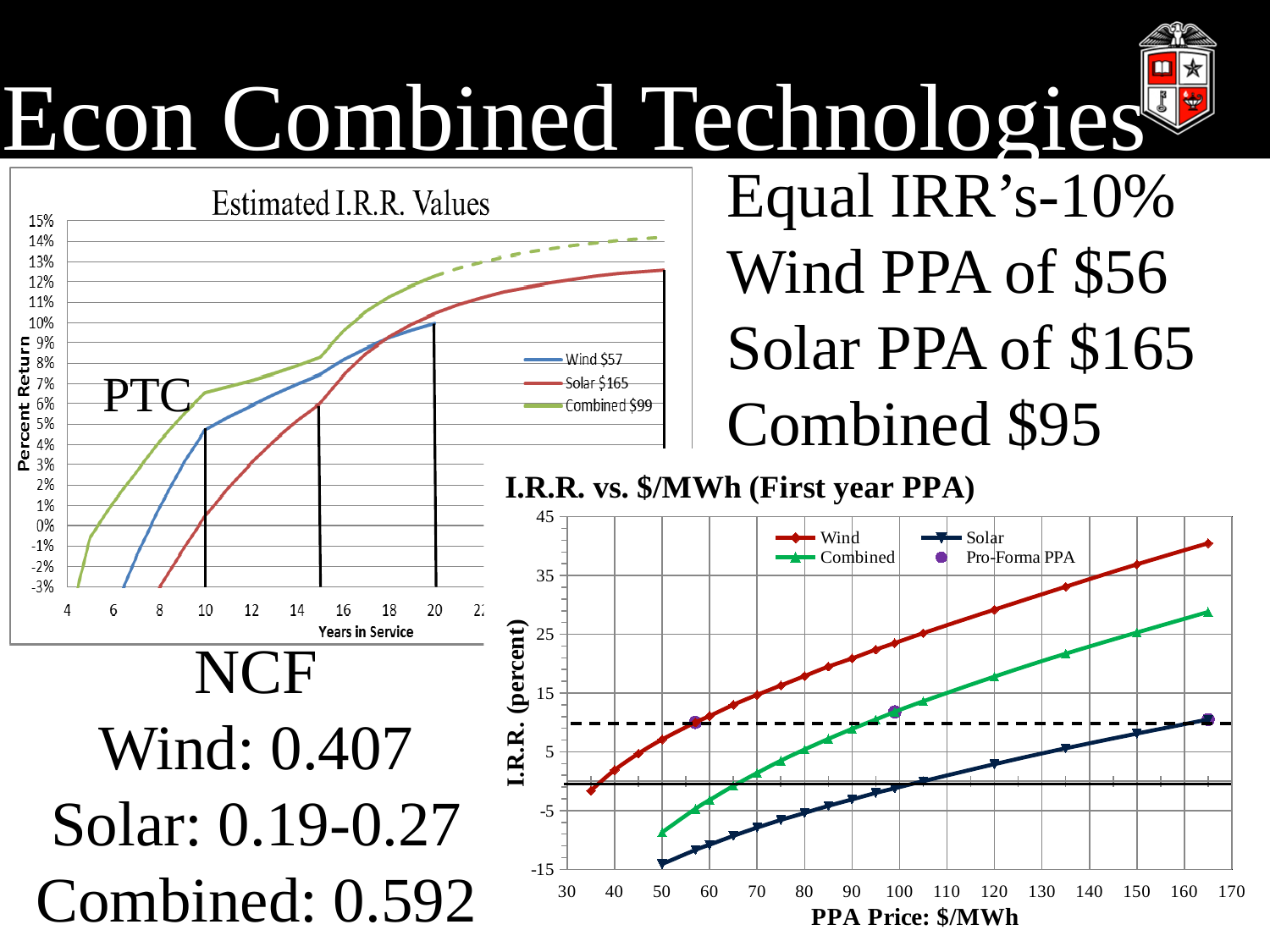
In the "Estimated I.R.R. Values" chart, which is higher at 20 years in service, the Combined line or the Wind line? Combined In the "I.R.R. vs. $/MWh (First year PPA)" chart, which series is lowest at a PPA price of 50? Solar What is the x-axis title of the "I.R.R. vs. $/MWh (First year PPA)" chart? PPA Price: $/MWh In the "I.R.R. vs. $/MWh (First year PPA)" chart, is the Combined value at a PPA price of 100 greater or less than 5? greater In the "Estimated I.R.R. Values" chart, is the Combined value at 10 years in service greater or less than 5%? greater In the "I.R.R. vs. $/MWh (First year PPA)" chart, does the Wind series rise or fall as PPA price increases? rise How many series does the legend of the "I.R.R. vs. $/MWh (First year PPA)" chart list? 4 In the "I.R.R. vs. $/MWh (First year PPA)" chart, which series is highest at a PPA price of 165? Wind In the "I.R.R. vs. $/MWh (First year PPA)" chart, is the Solar value at a PPA price of 50 greater or less than -5? less What kind of chart is the "Estimated I.R.R. Values" chart? line chart How many series does the legend of the "Estimated I.R.R. Values" chart list? 3